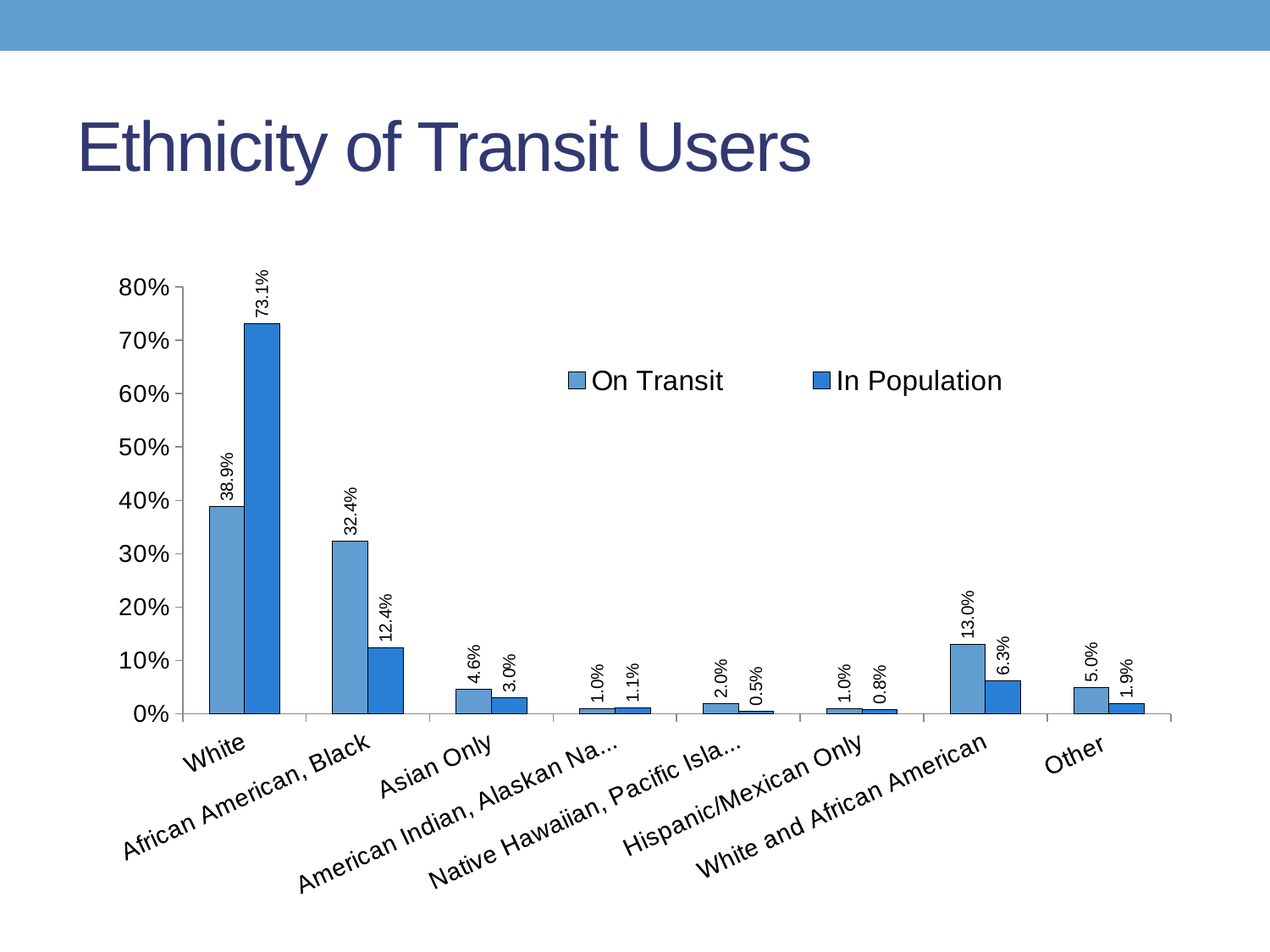
Which category has the highest In Population value? White How many series does the legend list? 2 Which category has the lowest In Population value? Native Hawaiian, Pacific Isla... Which is larger for Asian Only: the On Transit value or the In Population value? On Transit What is the difference between the In Population and On Transit values for White? 34.2% What is the In Population value for Other? 1.9% How many categories are shown on the x axis? 8 What is the On Transit value for White? 38.9% What is the On Transit value for White and African American? 13.0% What is the title of the slide? Ethnicity of Transit Users What kind of chart is shown on the slide? Bar chart What is the In Population value for African American, Black? 12.4%